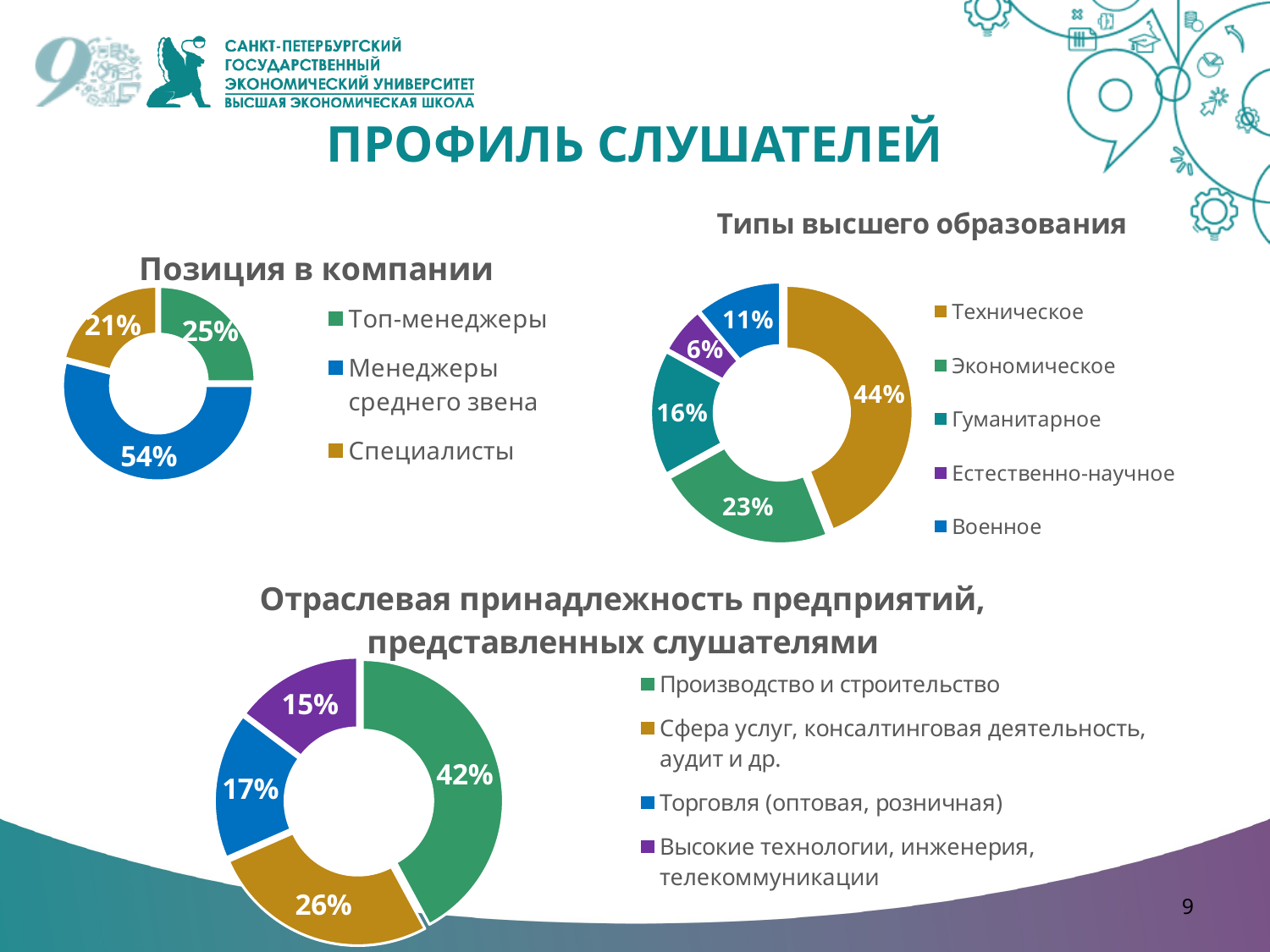
In the chart 'Отраслевая принадлежность предприятий, представленных слушателями', what share is shown for 'Торговля (оптовая, розничная)'? 17% In the chart 'Типы высшего образования', what share is shown for 'Гуманитарное'? 16% In the chart 'Отраслевая принадлежность предприятий, представленных слушателями', which category has the largest share? Производство и строительство In the chart 'Позиция в компании', what share is shown for 'Менеджеры среднего звена'? 54% In the chart 'Типы высшего образования', which category has the largest share? Техническое In the chart 'Позиция в компании', which category has the smallest share? Специалисты In the chart 'Отраслевая принадлежность предприятий, представленных слушателями', what is the difference between 'Производство и строительство' and 'Сфера услуг, консалтинговая деятельность, аудит и др.'? 16% In the chart 'Типы высшего образования', which is larger: 'Военное' or 'Естественно-научное'? Военное In the chart 'Позиция в компании', what is the difference between the shares of 'Топ-менеджеры' and 'Специалисты'? 4% What type of chart is used for 'Позиция в компании'? Doughnut chart In the chart 'Типы высшего образования', how many categories does the legend list? 5 In the chart 'Типы высшего образования', which category has the smallest share? Естественно-научное